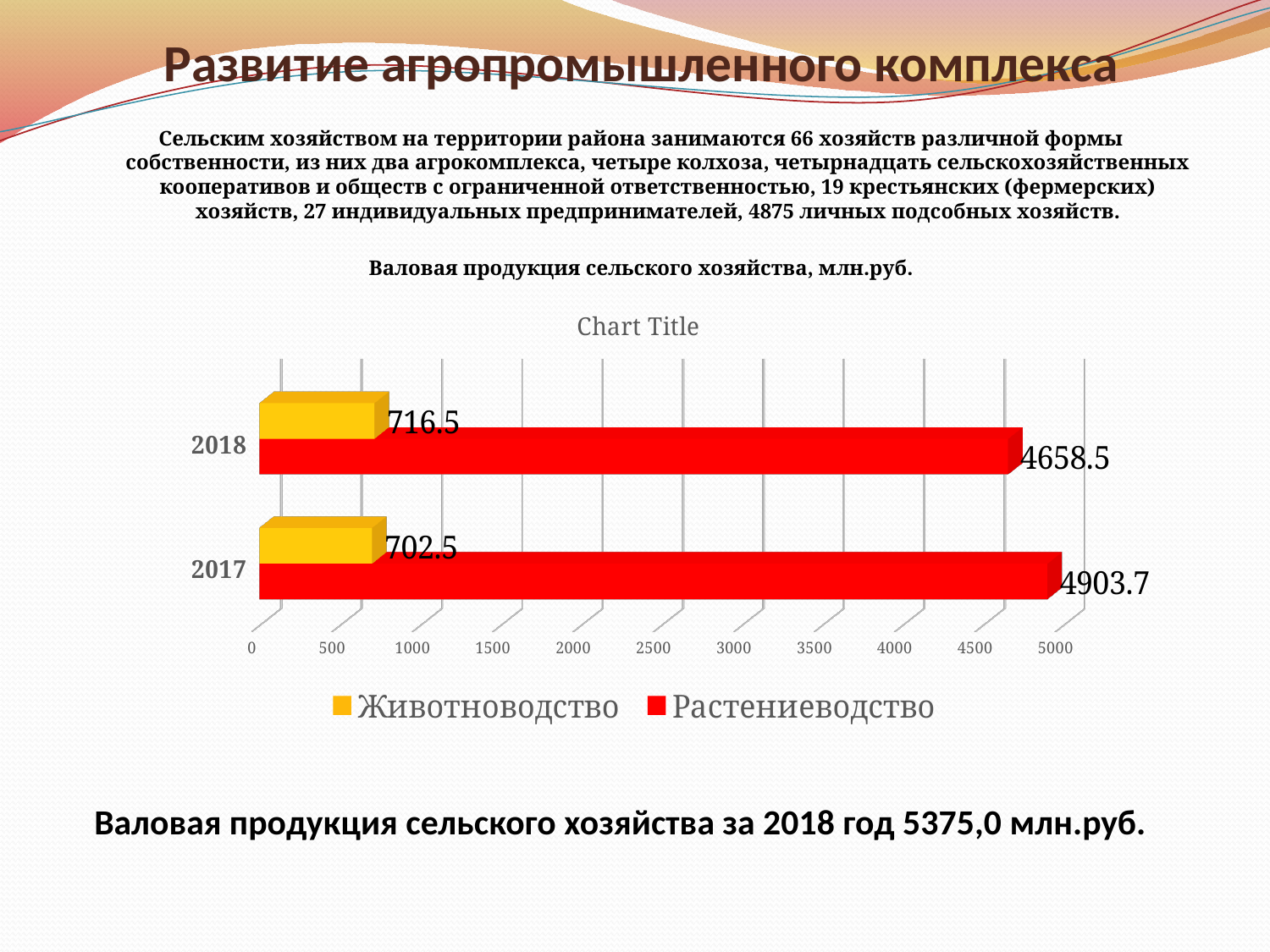
What is the value for Растениеводство in 2018? 4658.5 Which year has the higher value for Растениеводство? 2017 What is the difference between the Растениеводство values for 2017 and 2018? 245.2 Is the value for Растениеводство in 2018 greater or less than 4500? greater Which is larger: Животноводство in 2018 or Животноводство in 2017? Животноводство in 2018 Which year has the lower value for Животноводство? 2017 What is the value for Животноводство in 2017? 702.5 How many years are shown on the chart? 2 What is the value for Растениеводство in 2017? 4903.7 How many series does the legend list? 2 What is the value for Животноводство in 2018? 716.5 What kind of chart is shown on the slide? bar chart